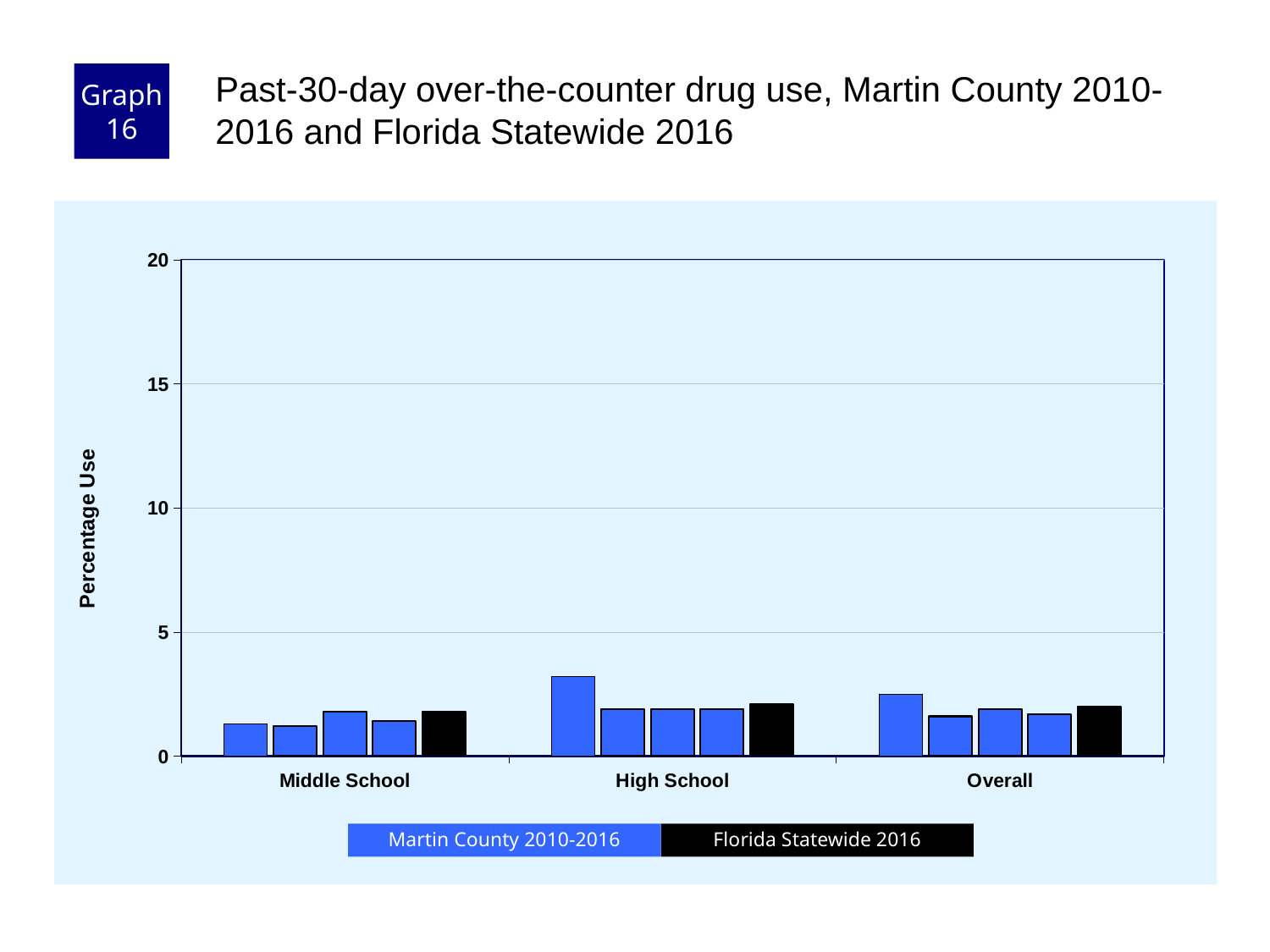
How many series does the legend list? 2 How many categories are shown on the x axis? 3 Is the Florida Statewide 2016 value for High School greater or less than 5? less What is the label on the y axis? Percentage Use What kind of chart is shown on the slide? bar chart Is the Florida Statewide 2016 value for Overall greater or less than 10? less Which category contains the tallest bar in the chart? High School Which series is shown in black in the legend? Florida Statewide 2016 Are any of the bars for Middle School greater than 5? No Which is larger: the tallest Martin County bar for High School or the tallest Martin County bar for Middle School? High School